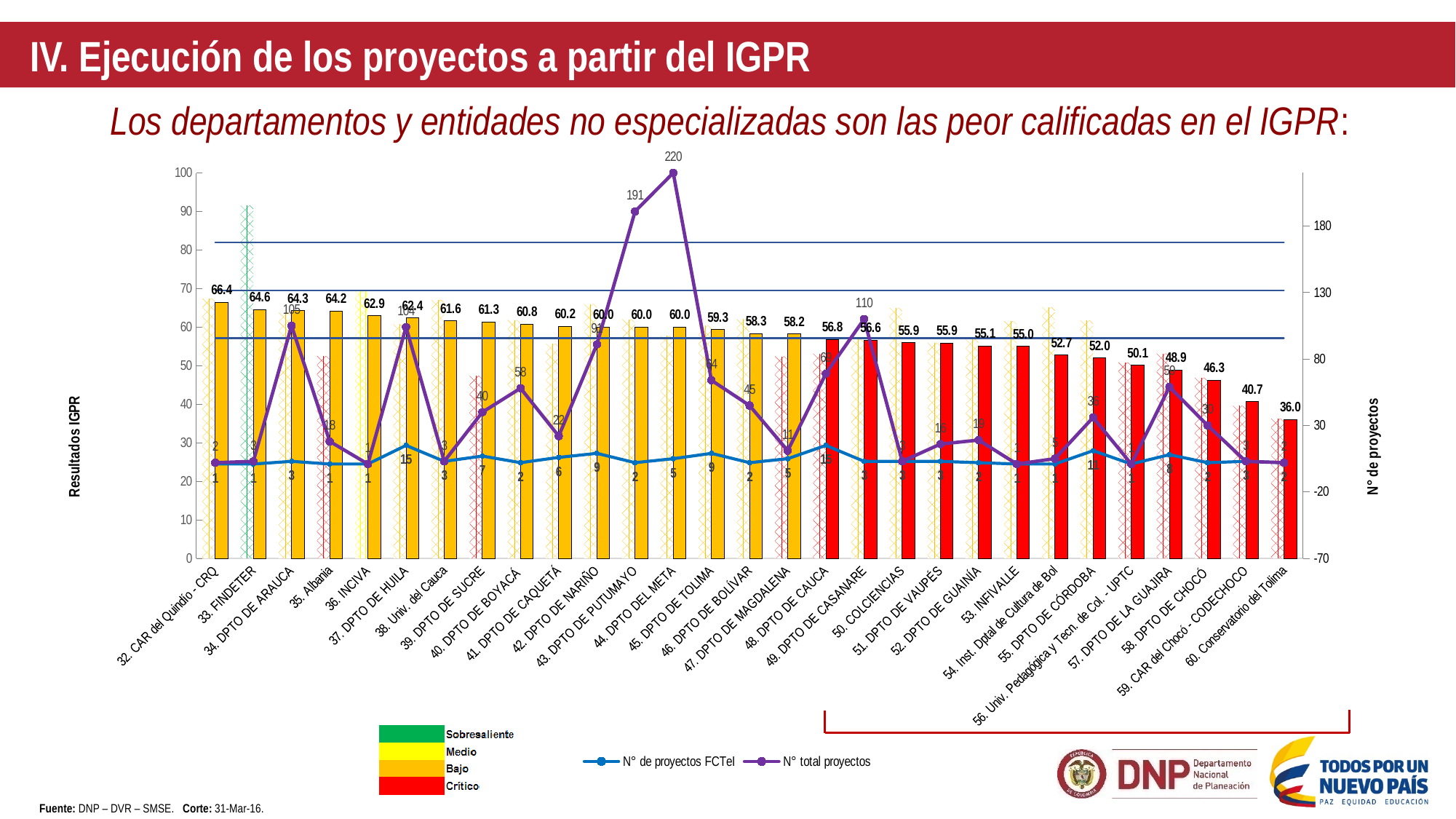
What is the IGPR result for 49. DPTO DE CASANARE? 56.6 What is the IGPR result for 32. CAR del Quindío - CRQ? 66.4 What kind of chart is shown on the slide? Combined bar and line chart What is the difference between the IGPR results of 33. FINDETER and 58. DPTO DE CHOCÓ? 18.3 Do the IGPR result bars rise or fall from left to right along the x axis? Fall What is the N° total proyectos value for 44. DPTO DEL META? 220 How many entities are shown on the x axis of the chart? 29 What is the IGPR result for 60. Conservatorio del Tolima? 36.0 Which entity has the lowest IGPR result bar? 60. Conservatorio del Tolima Which has a higher IGPR result, 36. INCIVA or 55. DPTO DE CÓRDOBA? 36. INCIVA How many line series does the legend at the bottom of the chart list? 2